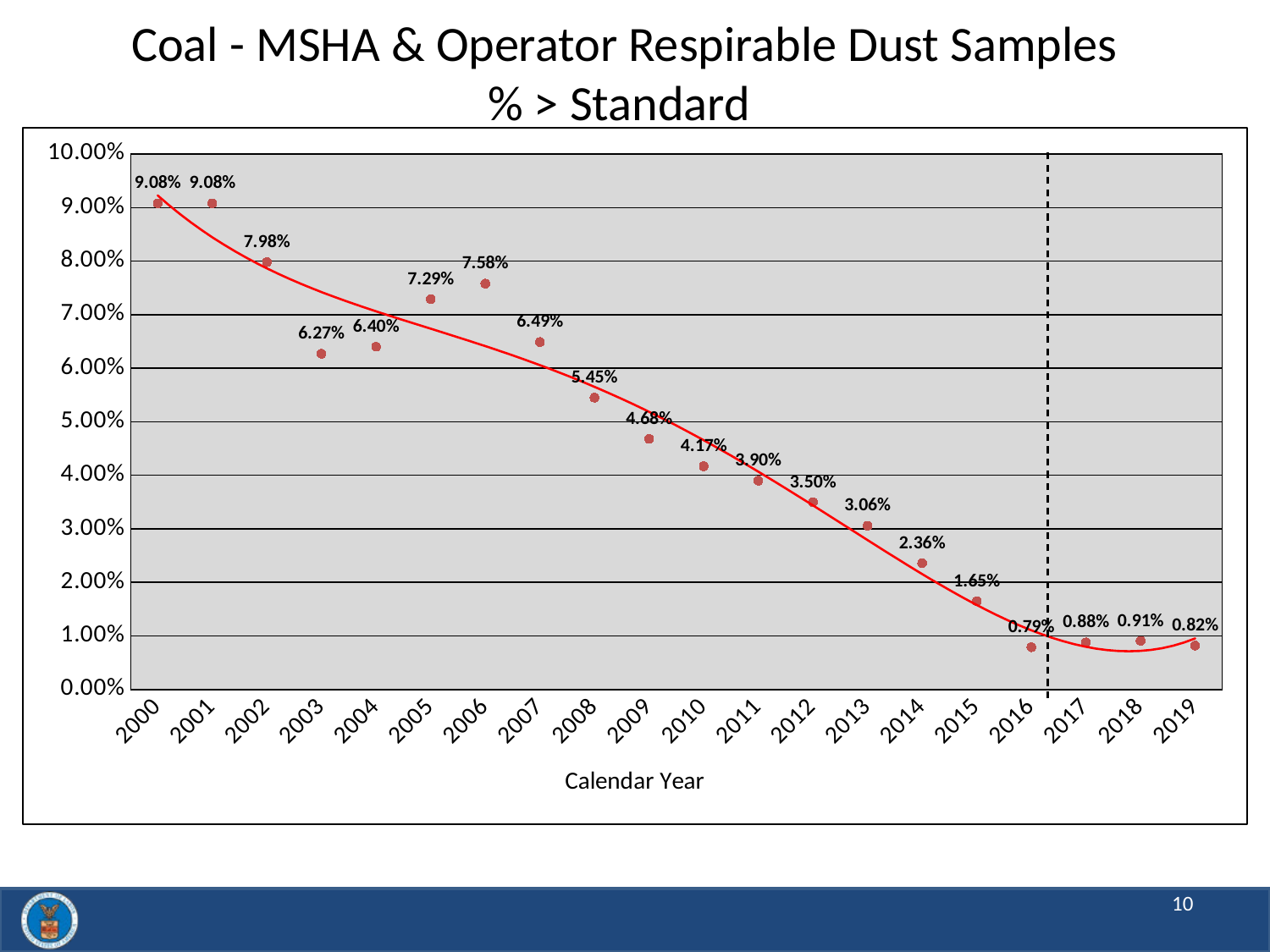
What is the value for 2007? 6.49% What is the label of the x axis? Calendar Year What is the value for 2019? 0.82% Which year has the lowest value? 2016 What is the value for 2014? 2.36% How many years are plotted on the chart? 20 What is the difference between the values for 2002 and 2003? 1.71% Which is larger, the value for 2005 or the value for 2006? 2006 What is the value for 2003? 6.27% Which is larger, the value for 2017 or the value for 2019? 2017 Do the values generally rise or fall from 2000 to 2019? fall What is the difference between the values for 2015 and 2016? 0.86%